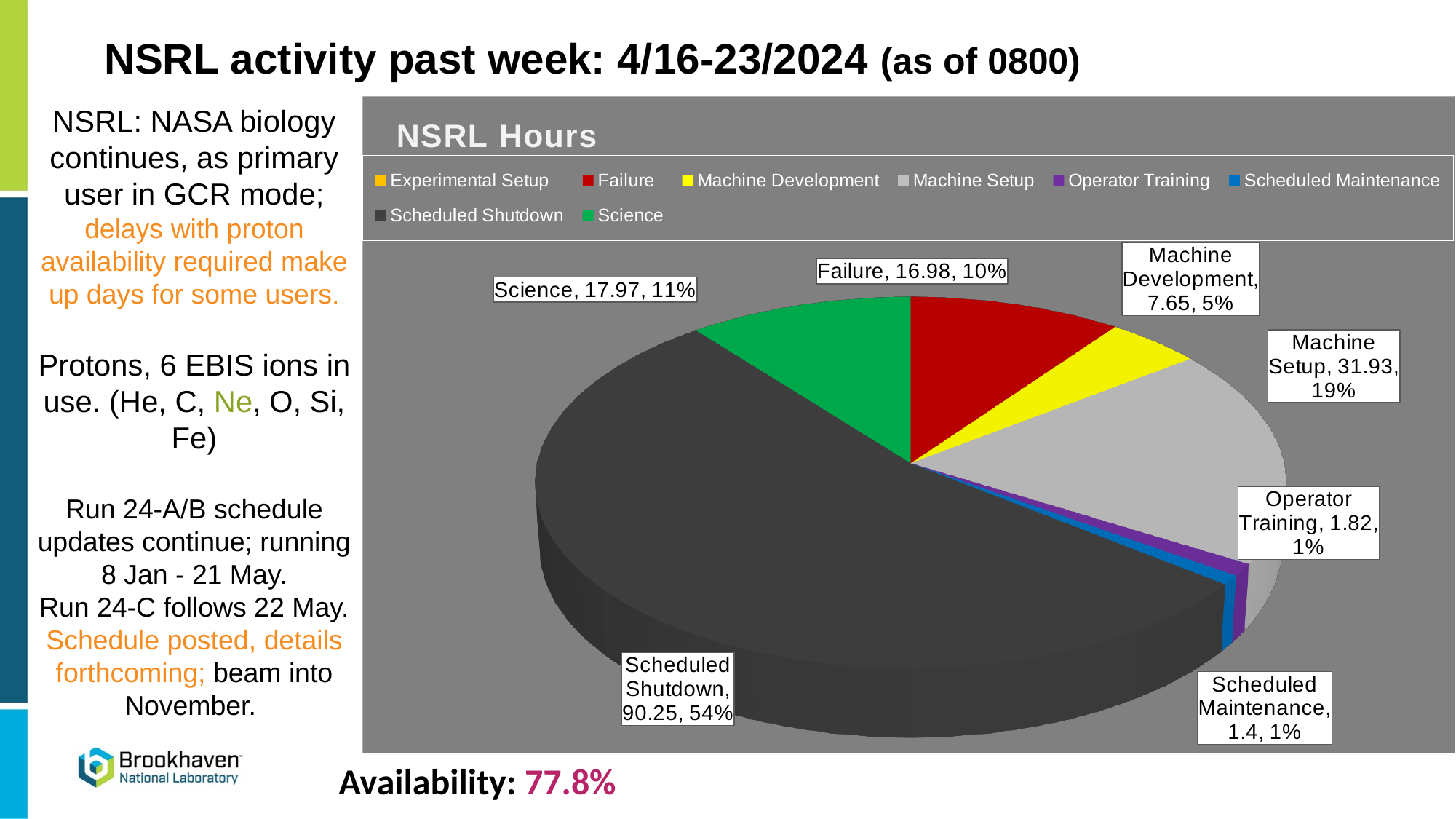
What type of chart is shown on the slide? pie chart Which category has the smallest labeled slice of the pie? Scheduled Maintenance What is the title of the chart? NSRL Hours What share of the pie does Science account for? 11% How many hours are shown for Operator Training? 1.82 What is the difference in hours between Machine Setup and Machine Development? 24.28 What share of the pie does Failure account for? 10% How many hours are shown for Scheduled Shutdown? 90.25 How many entries does the chart legend list? 8 Which category has the largest slice of the pie? Scheduled Shutdown How many hours are shown for Machine Setup? 31.93 Which has more hours, Science or Failure? Science